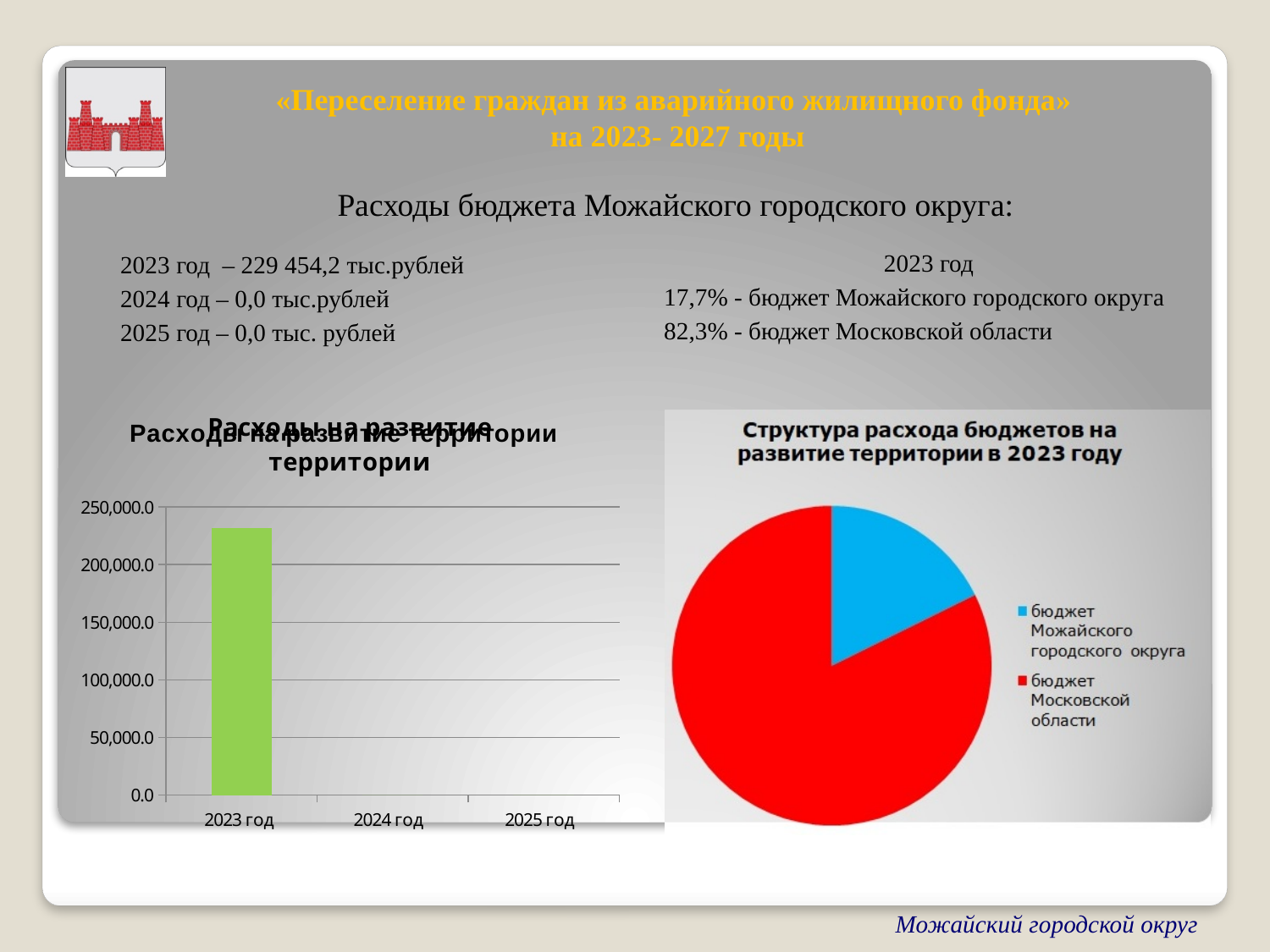
In the pie chart "Структура расхода бюджетов на развитие территории в 2023 году", how many entries does the legend list? 2 In the bar chart "Расходы на развитие территории", how many year categories are shown on the x axis? 3 In the pie chart "Структура расхода бюджетов на развитие территории в 2023 году", what colour is the slice for бюджет Можайского городского округа? blue In the bar chart "Расходы на развитие территории", what is the highest value shown on the vertical axis? 250,000.0 In the bar chart "Расходы на развитие территории", is the value for 2023 год greater or less than 250,000.0? less In the bar chart "Расходы на развитие территории", is the value for 2023 год greater or less than 200,000.0? greater In the pie chart "Структура расхода бюджетов на развитие территории в 2023 году", which slice is the largest? бюджет Московской области What kind of chart is the chart titled "Расходы на развитие территории"? bar chart In the bar chart "Расходы на развитие территории", which year has the highest value? 2023 год In the pie chart "Структура расхода бюджетов на развитие территории в 2023 году", what share does бюджет Московской области have according to the slide? 82,3% What kind of chart is the chart titled "Структура расхода бюджетов на развитие территории в 2023 году"? pie chart In the bar chart "Расходы на развитие территории", which is larger, the value for 2023 год or the value for 2024 год? 2023 год